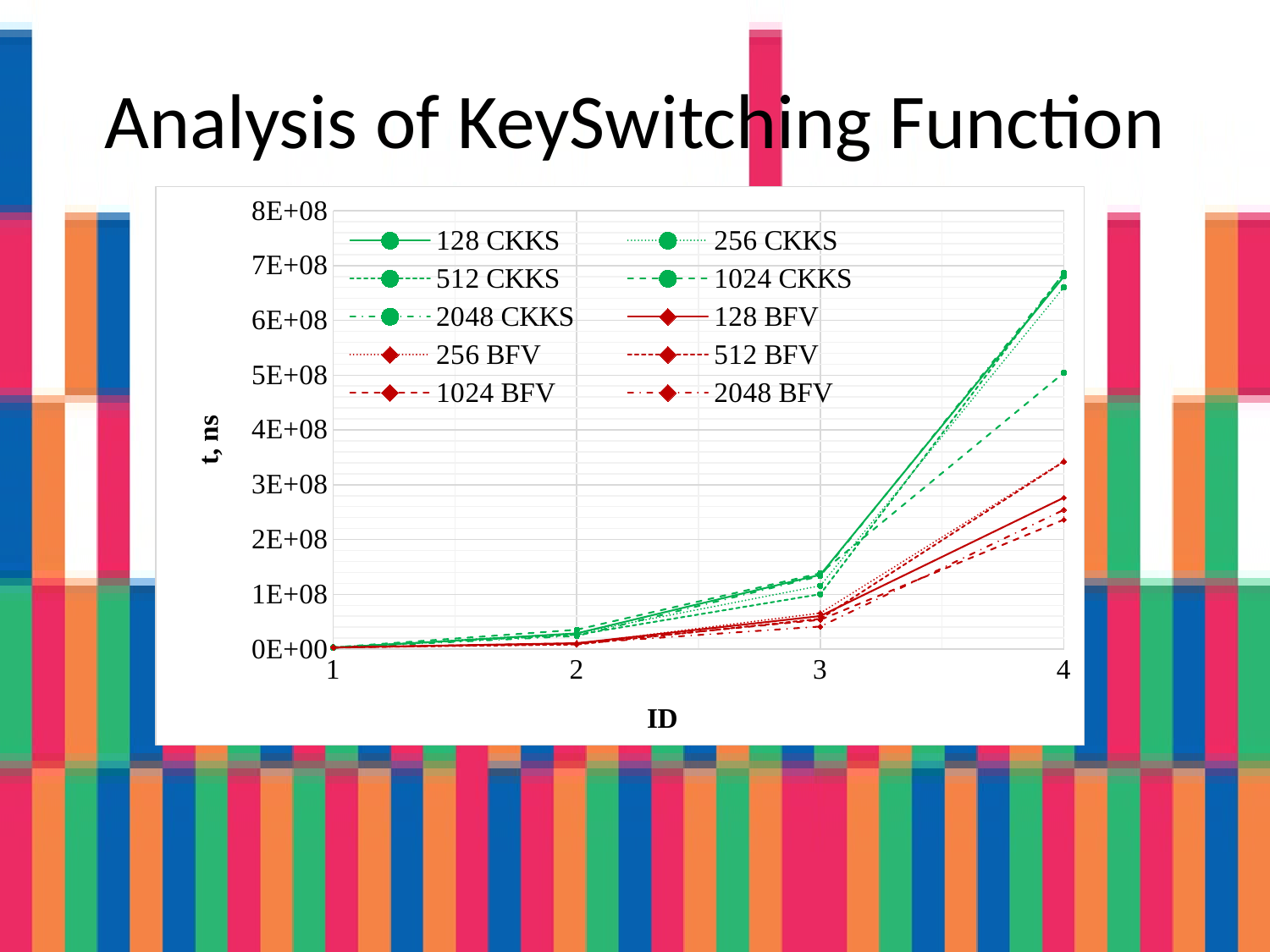
At ID 2, are all plotted values greater or less than 1E+08? less At ID 4, is the value for 128 CKKS greater or less than 6E+08? greater Do the values rise or fall as ID increases from 1 to 4? Rise How many ID values are plotted along the x axis? 4 At ID 4, is the value for 128 BFV greater or less than 4E+08? less At ID 4, which is larger, the value for 128 CKKS or the value for 128 BFV? 128 CKKS What is the label of the y axis? t, ns What is the title of the slide containing the chart? Analysis of KeySwitching Function How many series does the legend list? 10 What kind of chart is shown on the slide? Line chart At which ID do the series reach their highest values? 4